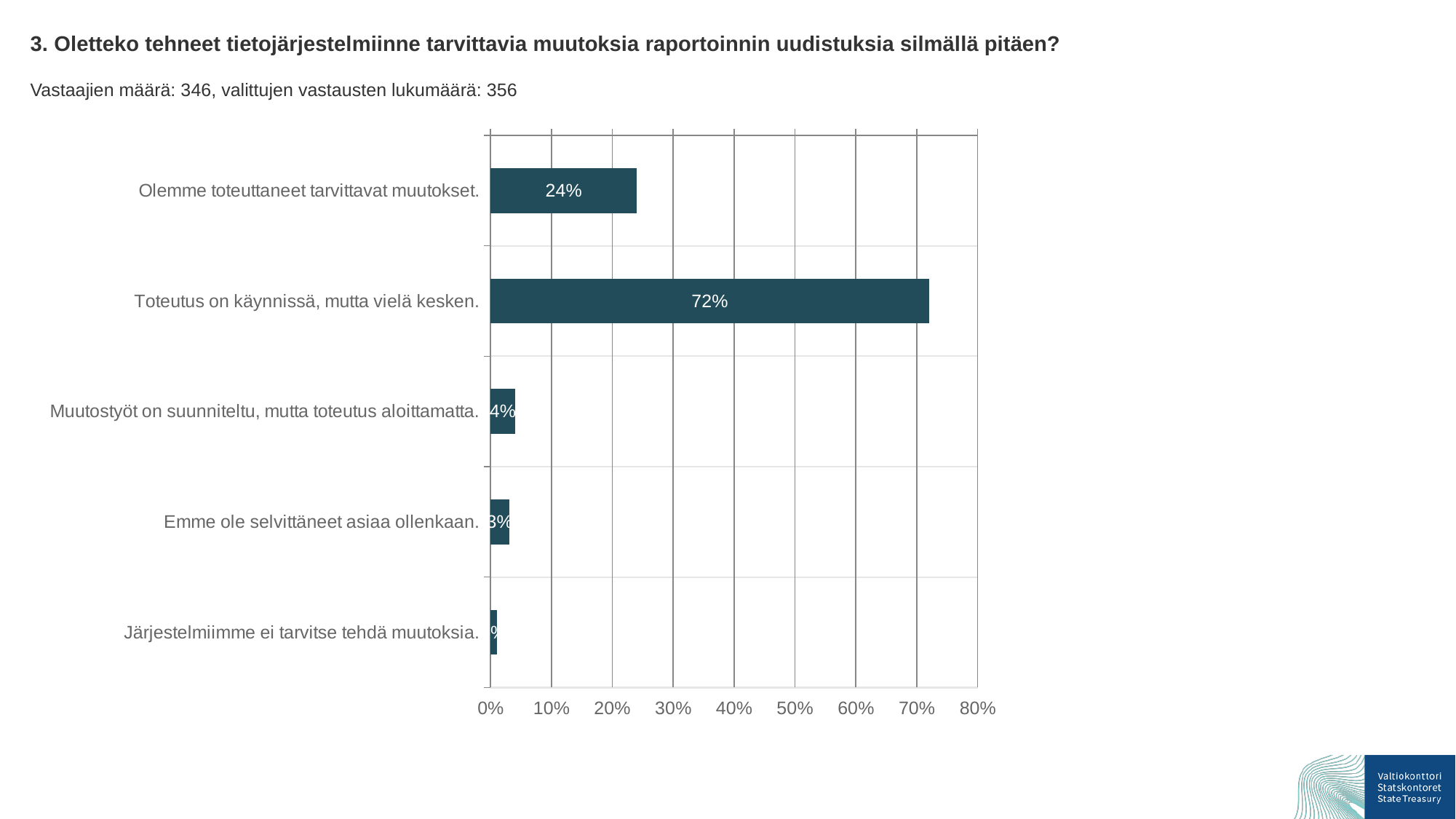
Which is larger: the value for "Olemme toteuttaneet tarvittavat muutokset." or for "Muutostyöt on suunniteltu, mutta toteutus aloittamatta."? Olemme toteuttaneet tarvittavat muutokset. How many categories are shown in the chart? 5 Which category has the lowest value? Järjestelmiimme ei tarvitse tehdä muutoksia. What is the difference between the values for "Toteutus on käynnissä, mutta vielä kesken." and "Olemme toteuttaneet tarvittavat muutokset."? 48% What is the value for "Toteutus on käynnissä, mutta vielä kesken."? 72% What is the value for "Olemme toteuttaneet tarvittavat muutokset."? 24% What kind of chart is shown on the slide? bar chart Is the value for "Järjestelmiimme ei tarvitse tehdä muutoksia." greater or less than 10%? less Which category has the highest value? Toteutus on käynnissä, mutta vielä kesken. Is the value for "Toteutus on käynnissä, mutta vielä kesken." greater or less than 70%? greater What is the value for "Emme ole selvittäneet asiaa ollenkaan."? 3% What is the value for "Muutostyöt on suunniteltu, mutta toteutus aloittamatta."? 4%